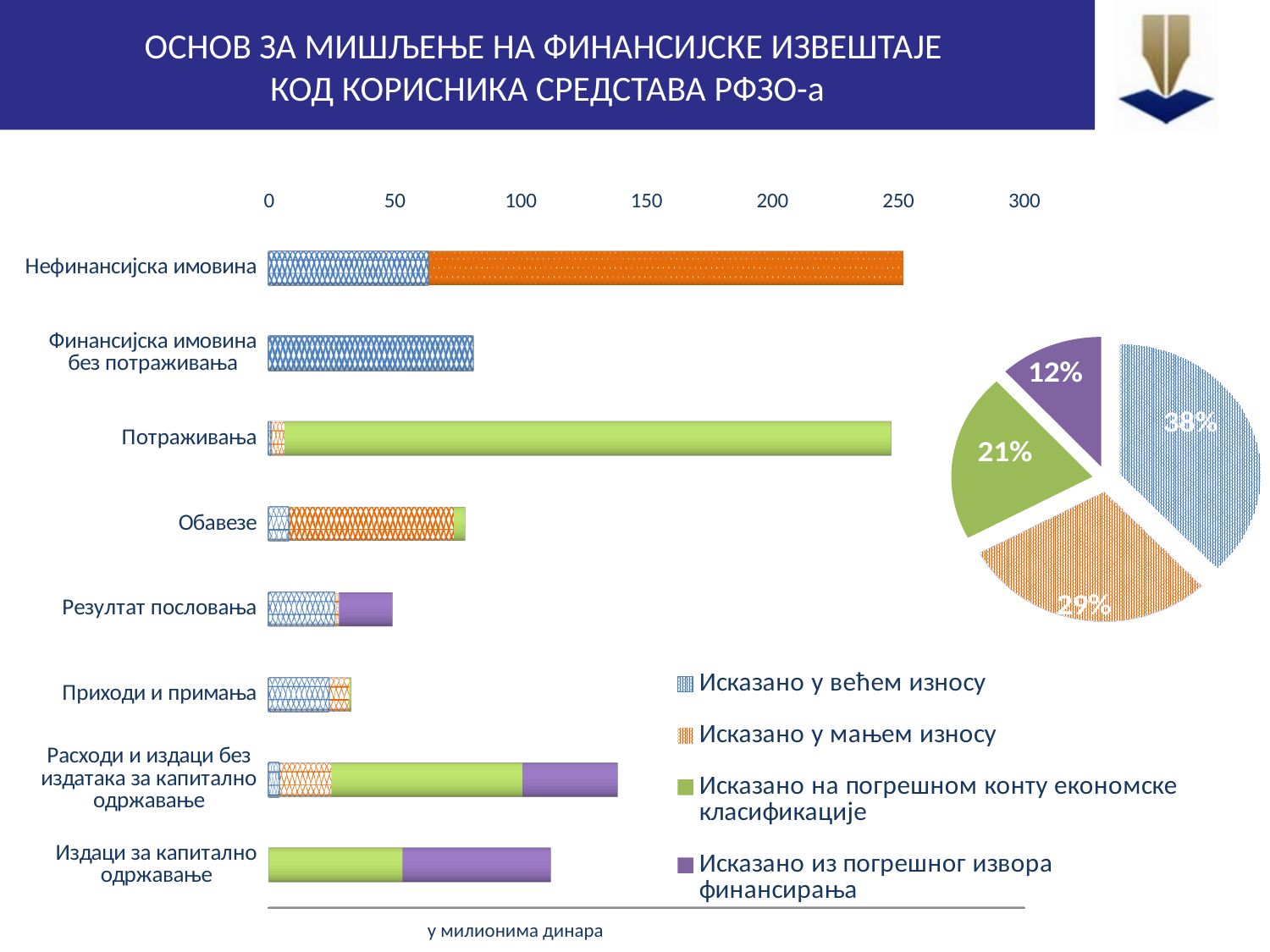
How many categories are shown on the bar chart on the left? 8 In the bar chart, is the total bar length for "Приходи и примања" greater or less than 50? less In the pie chart, what is the difference in percentage points between the largest slice (38%) and the smallest slice (12%)? 26 percentage points What kind of chart is the chart on the left side of the slide? Bar chart How many series does the legend list? 4 In the bar chart, is the total bar length for "Нефинансијска имовина" greater or less than 200? greater In the bar chart, which has the longer total bar, "Потраживања" or "Обавезе"? Потраживања